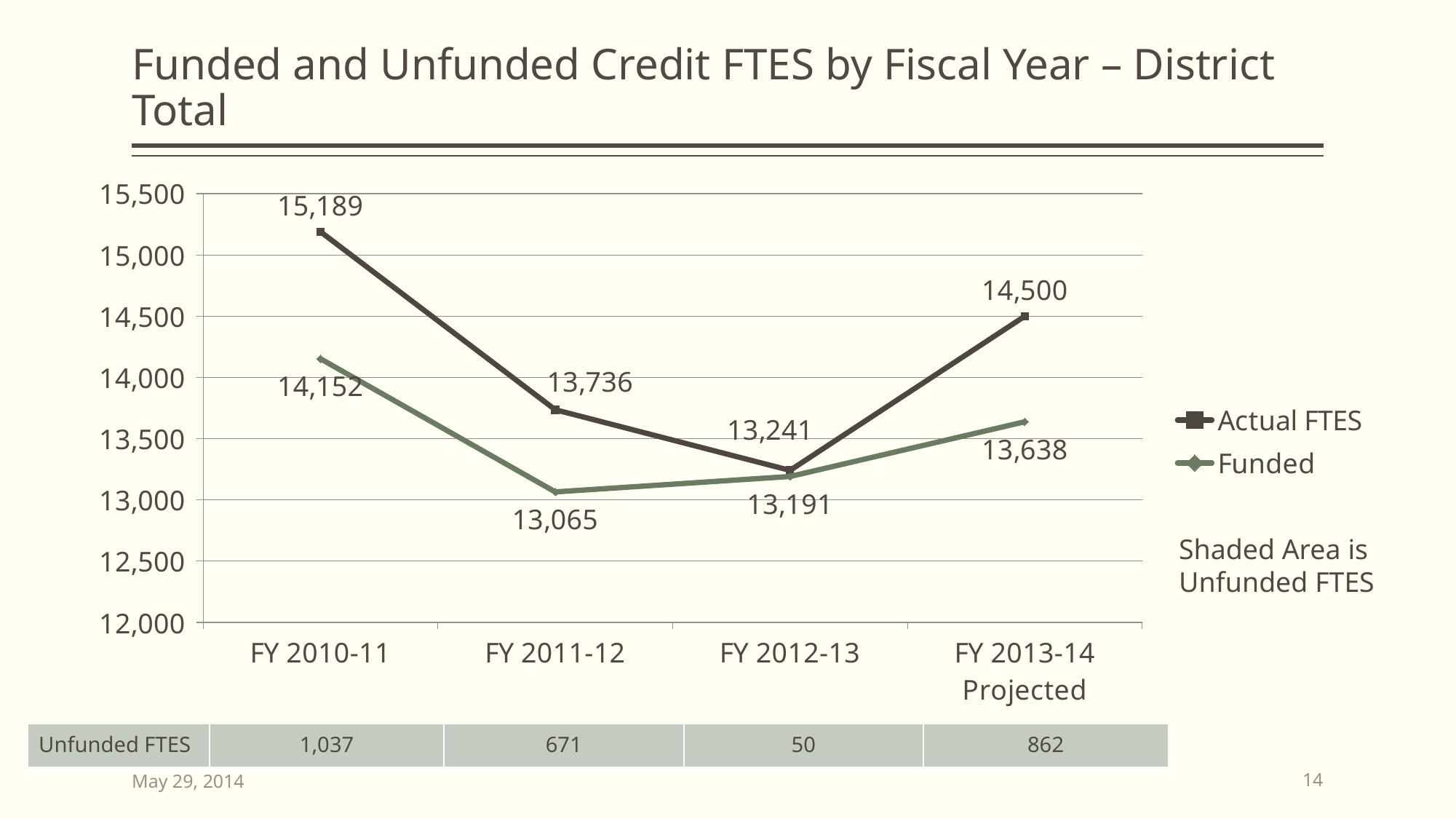
How many series does the legend list? 2 What is the difference between Actual FTES and Funded in FY 2010-11? 1,037 What is the Actual FTES value for FY 2010-11? 15,189 What is the Actual FTES value for FY 2013-14 Projected? 14,500 What is the Funded value for FY 2012-13? 13,191 In which fiscal year is the Funded value lowest? FY 2011-12 Which is larger in FY 2013-14 Projected: Actual FTES or Funded? Actual FTES In which fiscal year is Actual FTES highest? FY 2010-11 What is the Funded value for FY 2011-12? 13,065 How many fiscal years are plotted on the x axis? 4 What kind of chart is shown on the slide? Line chart What is the difference between Actual FTES in FY 2010-11 and FY 2011-12? 1,453